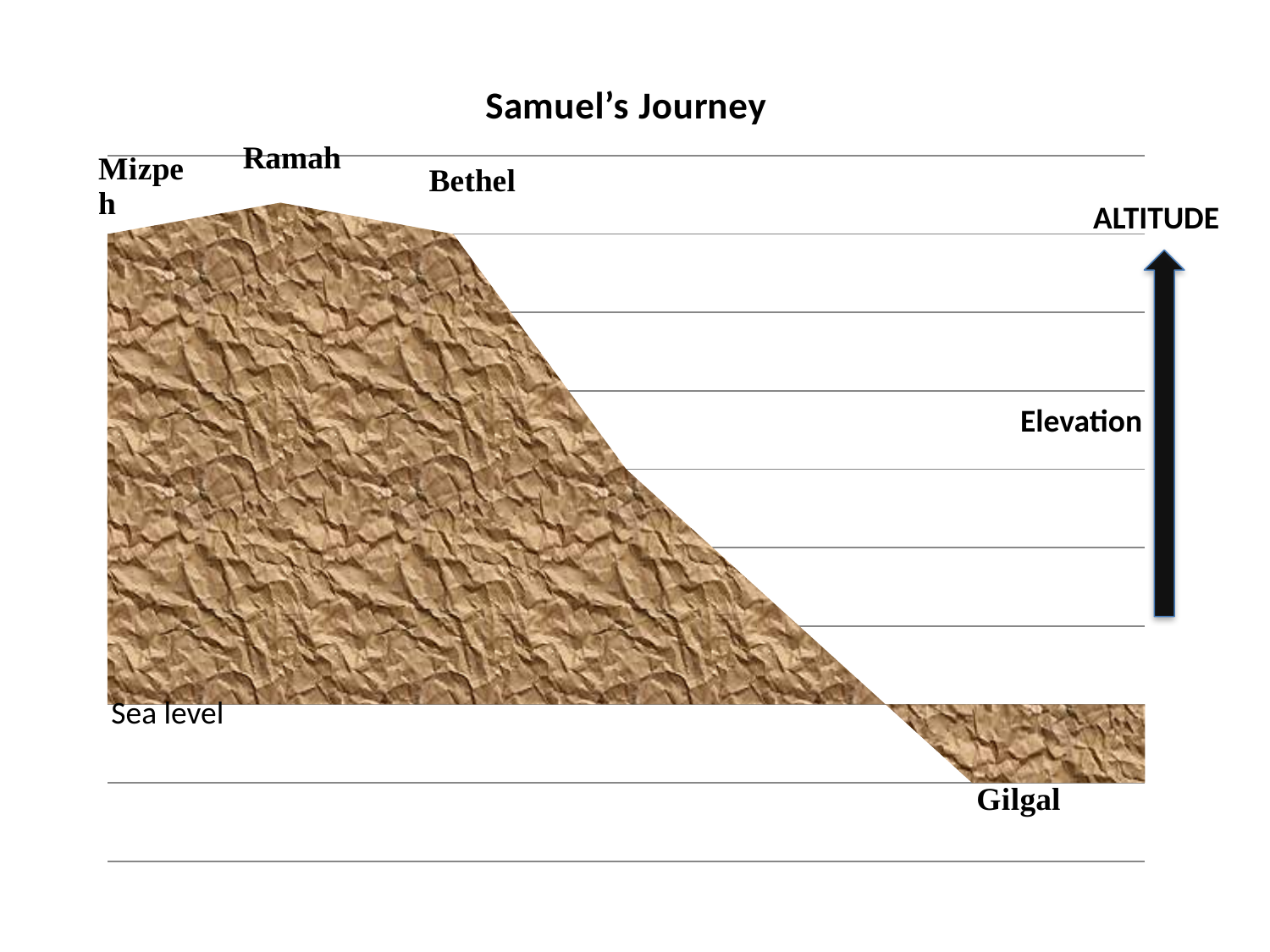
Which is at a higher elevation, Bethel or Gilgal? Bethel Does the elevation rise or fall from Mizpeh to Ramah? Rise Which location lies below sea level? Gilgal Which location has the lowest elevation? Gilgal Does the elevation rise or fall from Bethel to Gilgal? Fall What is the title of the chart? Samuel's Journey What kind of chart is shown on the slide? Area chart How many named locations are marked along the journey? 4 Which is at a higher elevation, Ramah or Gilgal? Ramah Which location has the highest elevation? Ramah